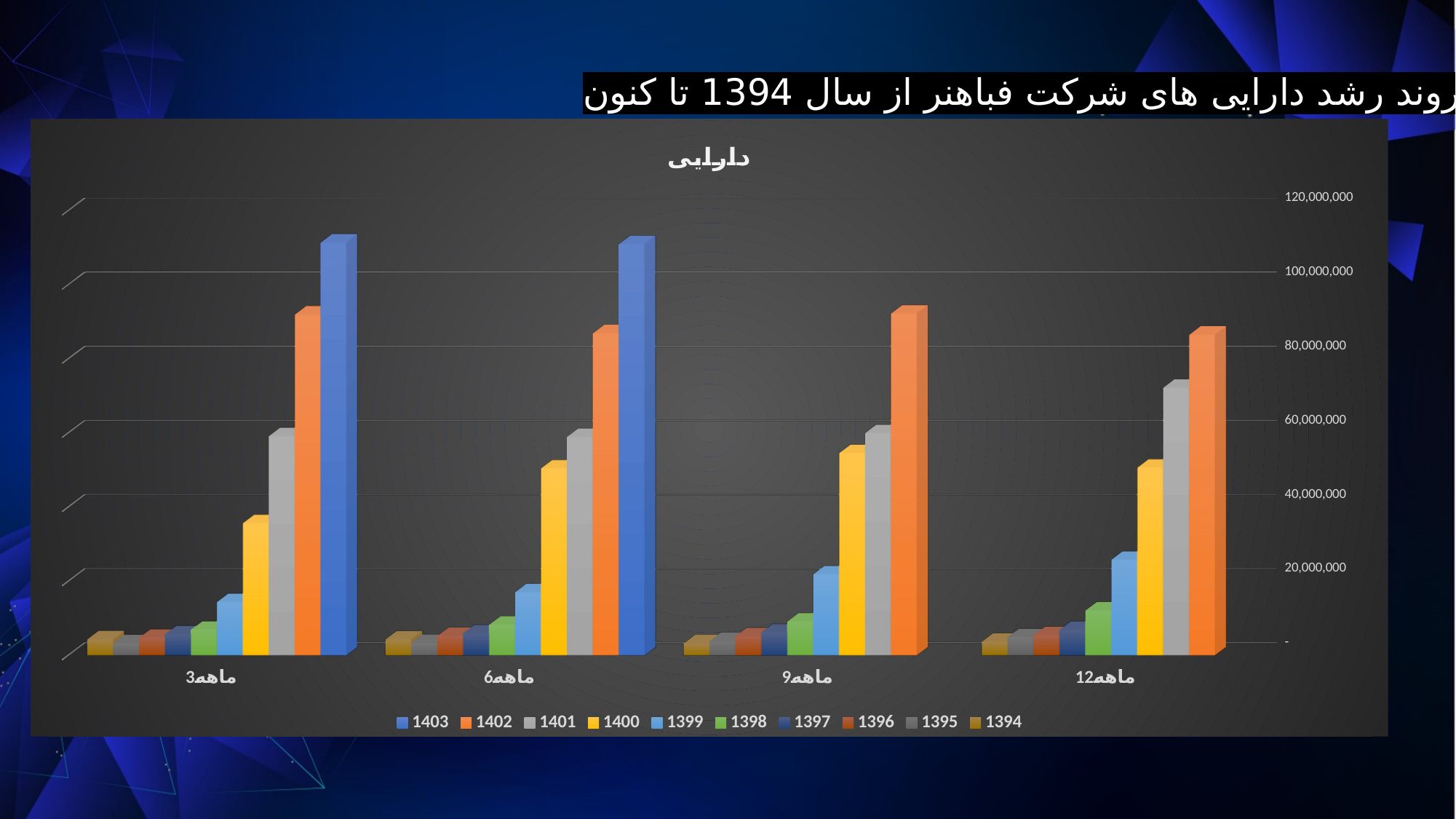
What kind of chart is shown on the slide? bar chart Which series has the highest value in the 3ماهه category? 1403 Do the values for series 1399 rise or fall from 3ماهه to 12ماهه? rise Is the value for 1401 in the 12ماهه category greater or less than 60,000,000? greater How many series does the legend list? 10 In the 9ماهه category, which is larger: the value for 1402 or the value for 1401? 1402 Is the value for 1400 in the 3ماهه category greater or less than 40,000,000? less Which series has the highest value in the 12ماهه category? 1402 Is the value for 1403 in the 3ماهه category greater or less than 100,000,000? greater How many categories are shown on the x axis? 4 What is the title of the chart? دارایی